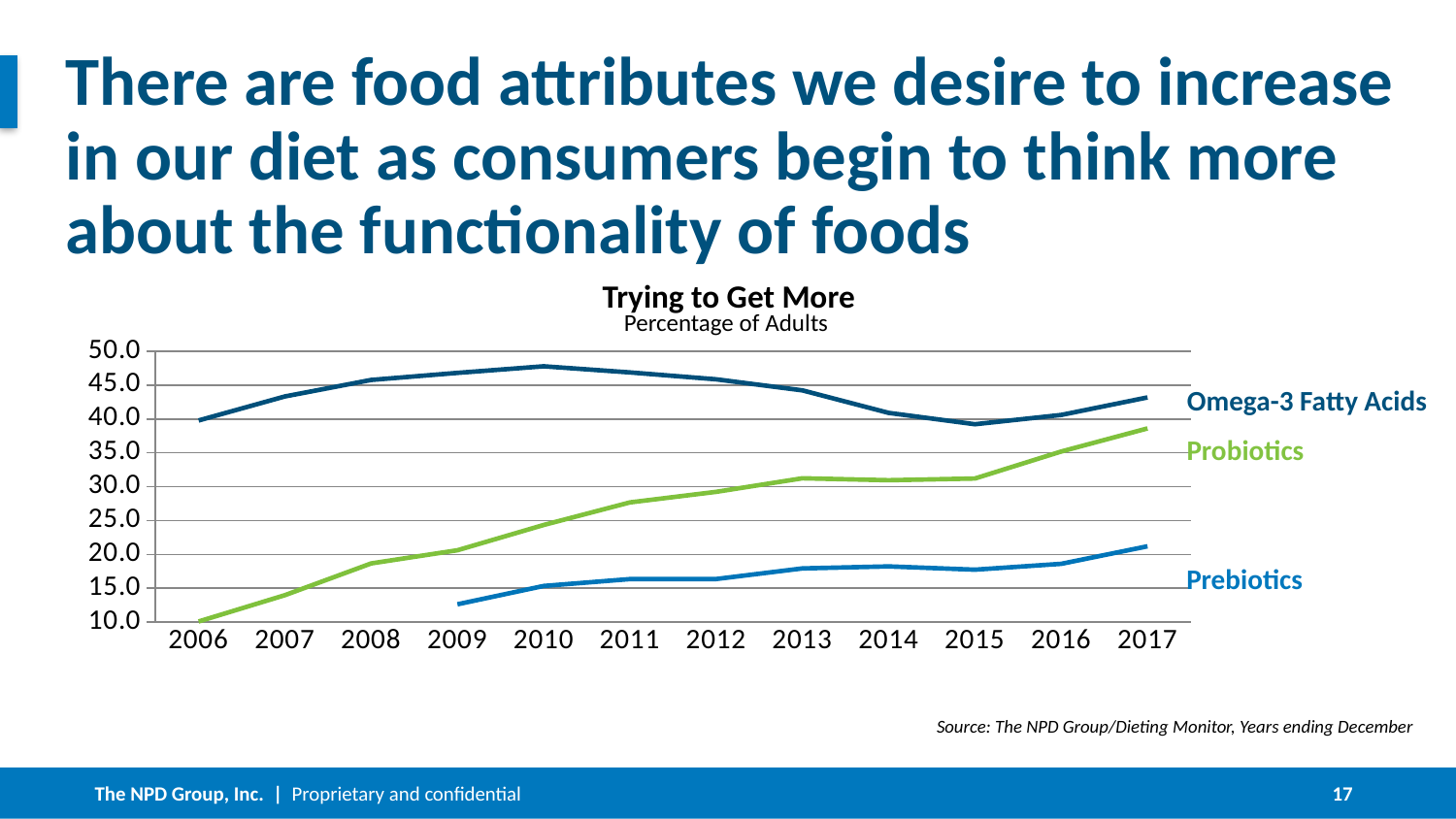
Does the Probiotics line rise or fall from 2006 to 2017? Rise Is the value for Probiotics in 2006 greater or less than 15.0? less Which series has the highest value in 2017? Omega-3 Fatty Acids Which series has the lowest value in 2017? Prebiotics What kind of chart is shown on the slide? Line chart How many series are plotted on the chart? 3 In 2017, which is larger: the value for Probiotics or the value for Prebiotics? Probiotics What is the title of the chart? Trying to Get More What does the chart's subtitle say the values represent? Percentage of Adults How many years are shown on the x axis of the chart? 12 Is the value for Omega-3 Fatty Acids in 2010 greater or less than 45.0? greater Is the value for Prebiotics in 2017 greater or less than 15.0? greater